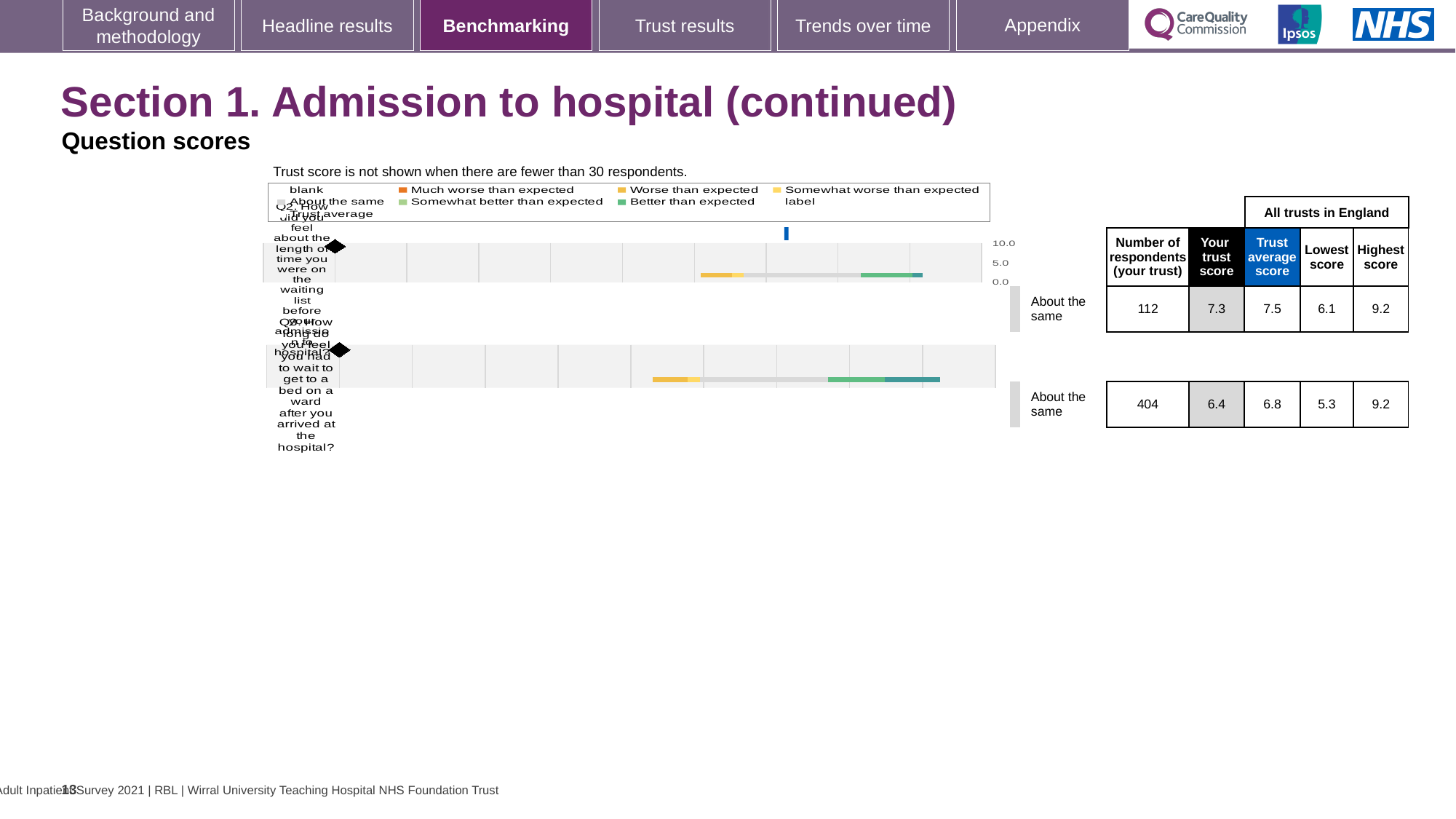
How many questions are plotted on the slide? 2 What is the trust average score across all trusts in England for Q3? 6.8 Which question has the higher 'Your trust score', Q2 or Q3? Q2 What benchmark category is shown next to the Q2 chart? About the same What is the 'Your trust score' for Q2 (length of time on the waiting list before admission)? 7.3 By how much does the trust average score exceed this trust's score for Q3? 0.4 Is the trust score for Q3 greater or less than 5.0 on the chart axis? greater What kind of chart is used to show the question scores? bar chart What is the lowest score among all trusts in England for Q3? 5.3 How many respondents from the trust answered Q2? 112 What is the 'Your trust score' for Q3 (wait to get to a bed on a ward after arriving at the hospital)? 6.4 What is the difference between the highest score and the lowest score for Q2? 3.1